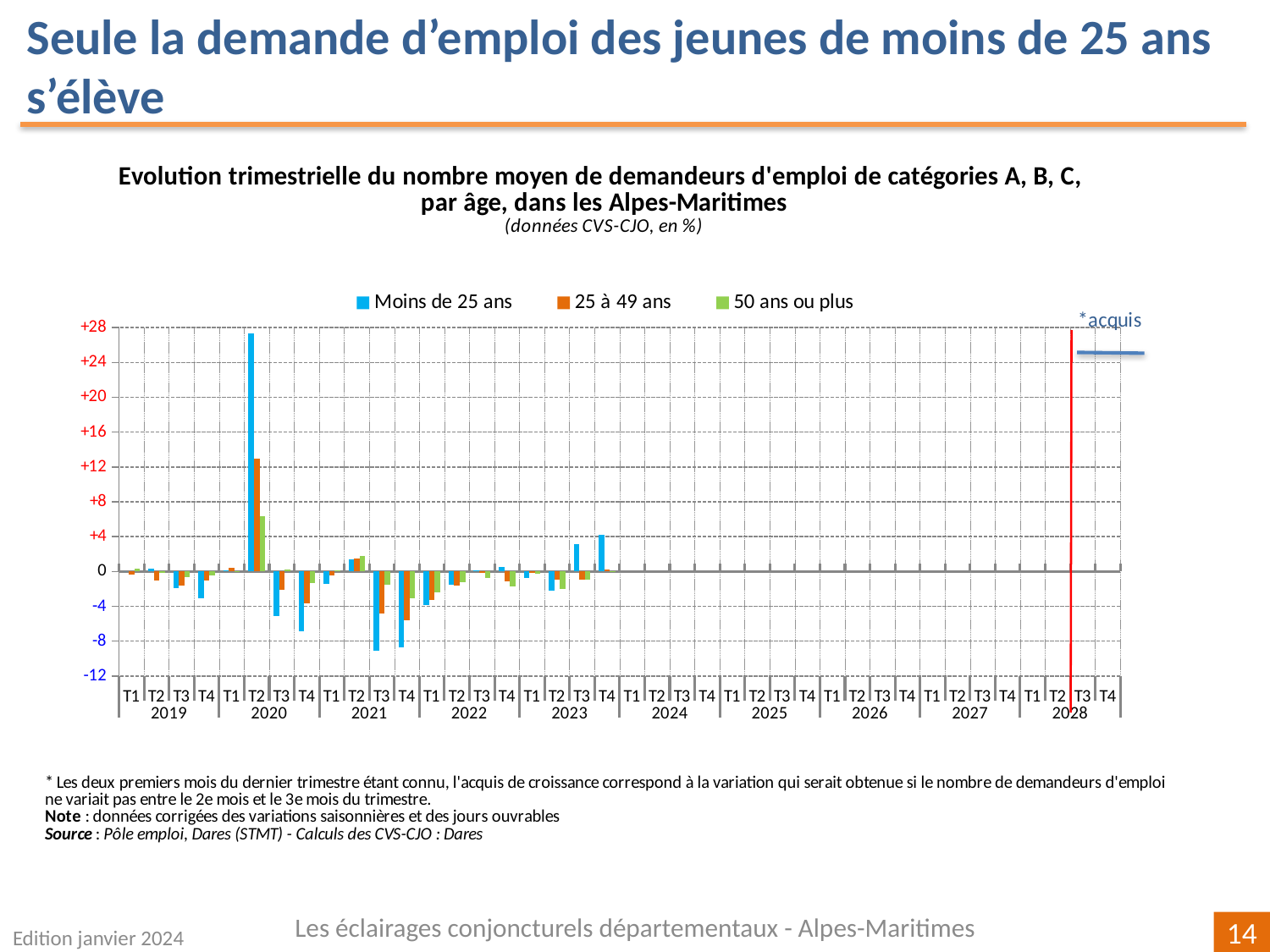
In which quarter does the 'Moins de 25 ans' series reach its highest value? T2 2020 What is the highest value shown on the y axis? +28 In T4 2023, which series has the larger value: 'Moins de 25 ans' or '25 à 49 ans'? Moins de 25 ans What kind of chart is shown on the slide? bar chart In T2 2020, which series has the larger value: 'Moins de 25 ans' or '25 à 49 ans'? Moins de 25 ans Which series are listed in the legend? Moins de 25 ans, 25 à 49 ans, 50 ans ou plus Is the value for 'Moins de 25 ans' in T2 2020 greater or less than +24? greater Is the value for '25 à 49 ans' in T2 2020 greater or less than +12? greater Is the value for 'Moins de 25 ans' in T3 2021 greater or less than -8? less How many years are labelled along the x axis? 10 How many series does the legend list? 3